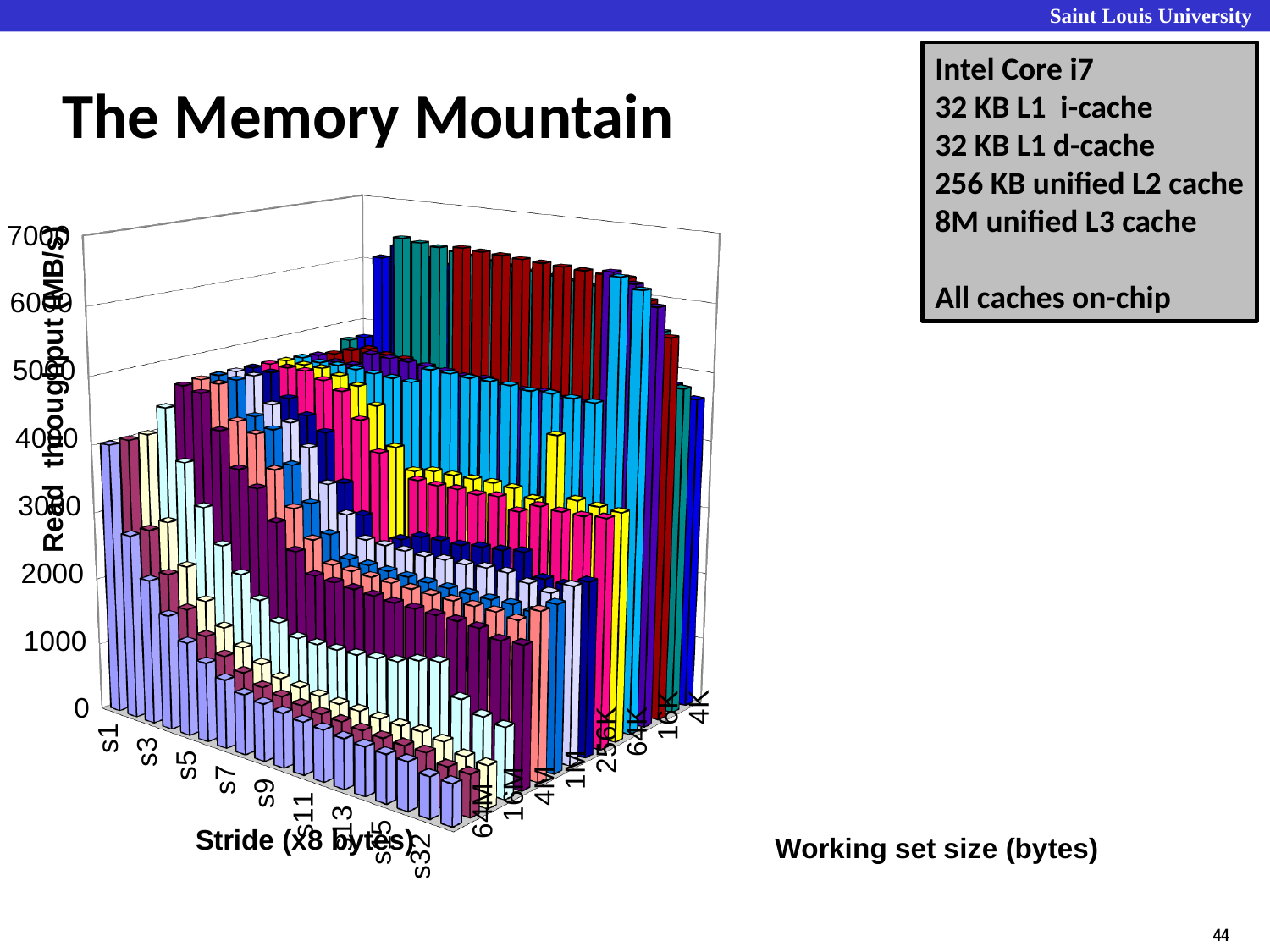
What is the title of the chart on the slide? The Memory Mountain For working set size 64M, does read throughput rise or fall as the stride increases from s1 to s32? fall Is the read throughput for stride s1 at working set size 64M greater or less than 6000? less How many working set size labels are shown along the working set size axis? 8 What kind of chart is shown on the slide? 3D bar chart What is the highest tick value shown on the read throughput axis? 7000 What is the label of the vertical axis of the chart? Read throughput (MB/s) How many stride labels are shown along the stride axis? 9 Is the read throughput for stride s32 at working set size 64M greater or less than 2000? less Is the read throughput for stride s1 at working set size 4K greater or less than 4000? greater